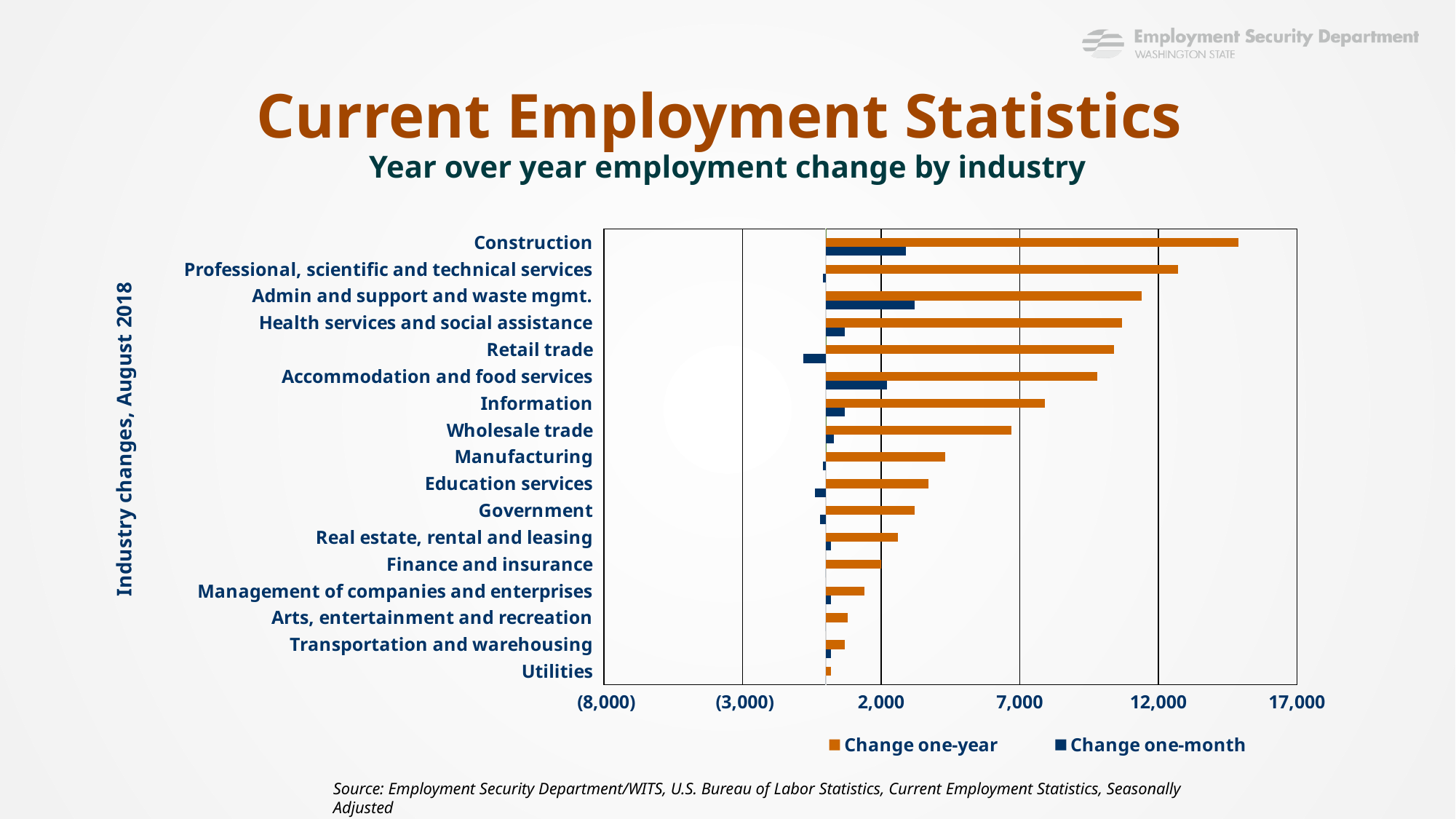
Which industry has the highest one-year employment change? Construction Is the one-year change for Health services and social assistance greater or less than 12,000? less How many series does the legend list? 2 Is the one-year change for Information greater or less than 7,000? greater Which colour represents the Change one-year series? Orange Which has the larger one-year change, Retail trade or Accommodation and food services? Retail trade Is the one-year change for Arts, entertainment and recreation greater or less than 2,000? less How many industries are plotted on the chart? 17 Which industry has the lowest one-month employment change? Retail trade What kind of chart is shown on the slide? Bar chart Which industry has the lowest one-year employment change? Utilities